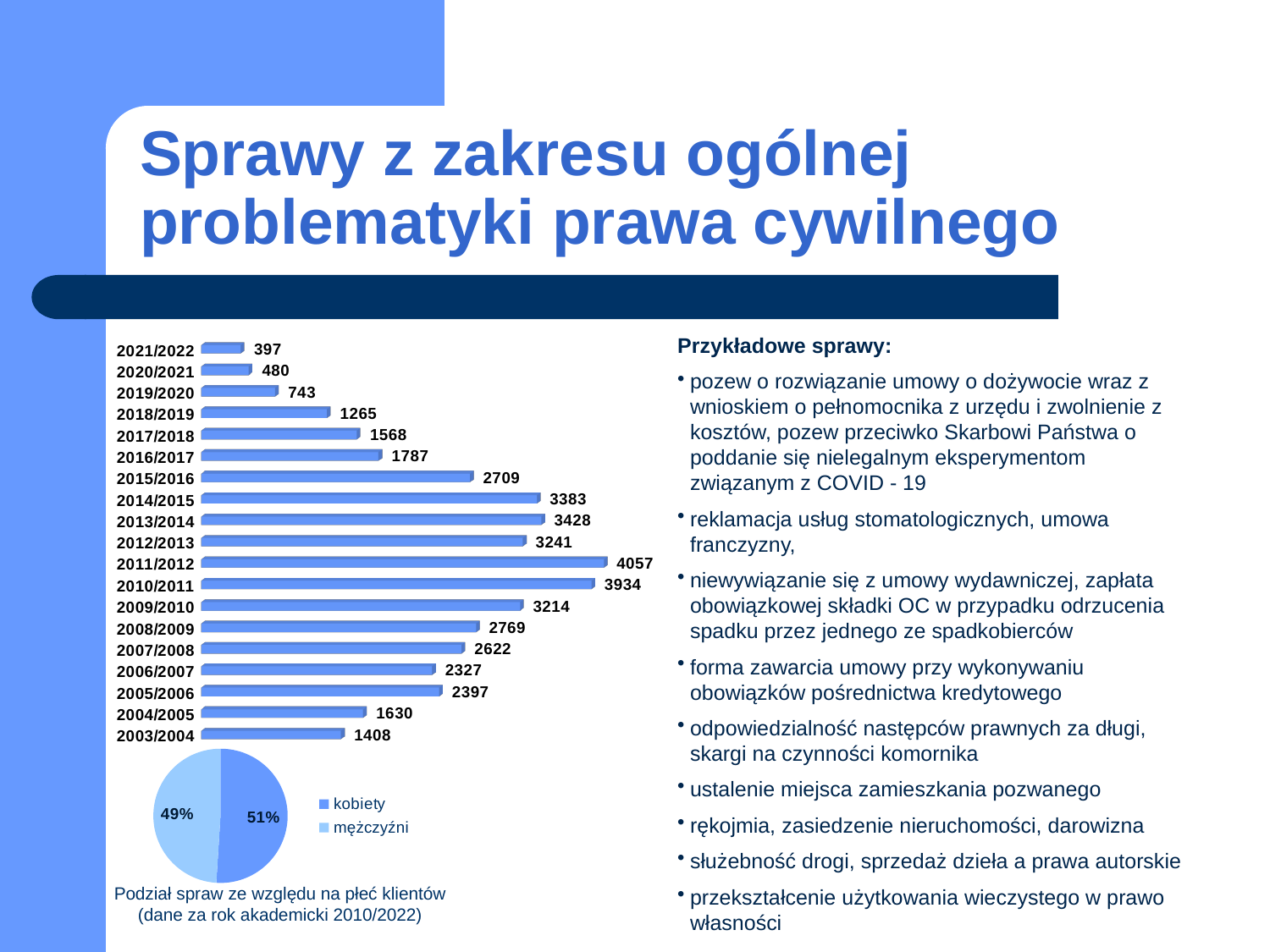
How many entries does the legend of the pie chart list? 2 In the pie chart, which slice is larger, kobiety or mężczyźni? kobiety In the pie chart, what share is labelled for kobiety? 51% In the bar chart, what is the value for 2019/2020? 743 How many academic years are shown in the bar chart? 19 In the bar chart, what is the value for 2011/2012? 4057 In the bar chart, which is larger, the value for 2013/2014 or the value for 2014/2015? 2013/2014 In the bar chart, which academic year has the lowest value? 2021/2022 What kind of chart is the chart showing values by academic year? bar chart In the bar chart, what is the difference between the values for 2011/2012 and 2010/2011? 123 In the bar chart, what is the value for 2003/2004? 1408 In the bar chart, which academic year has the highest value? 2011/2012